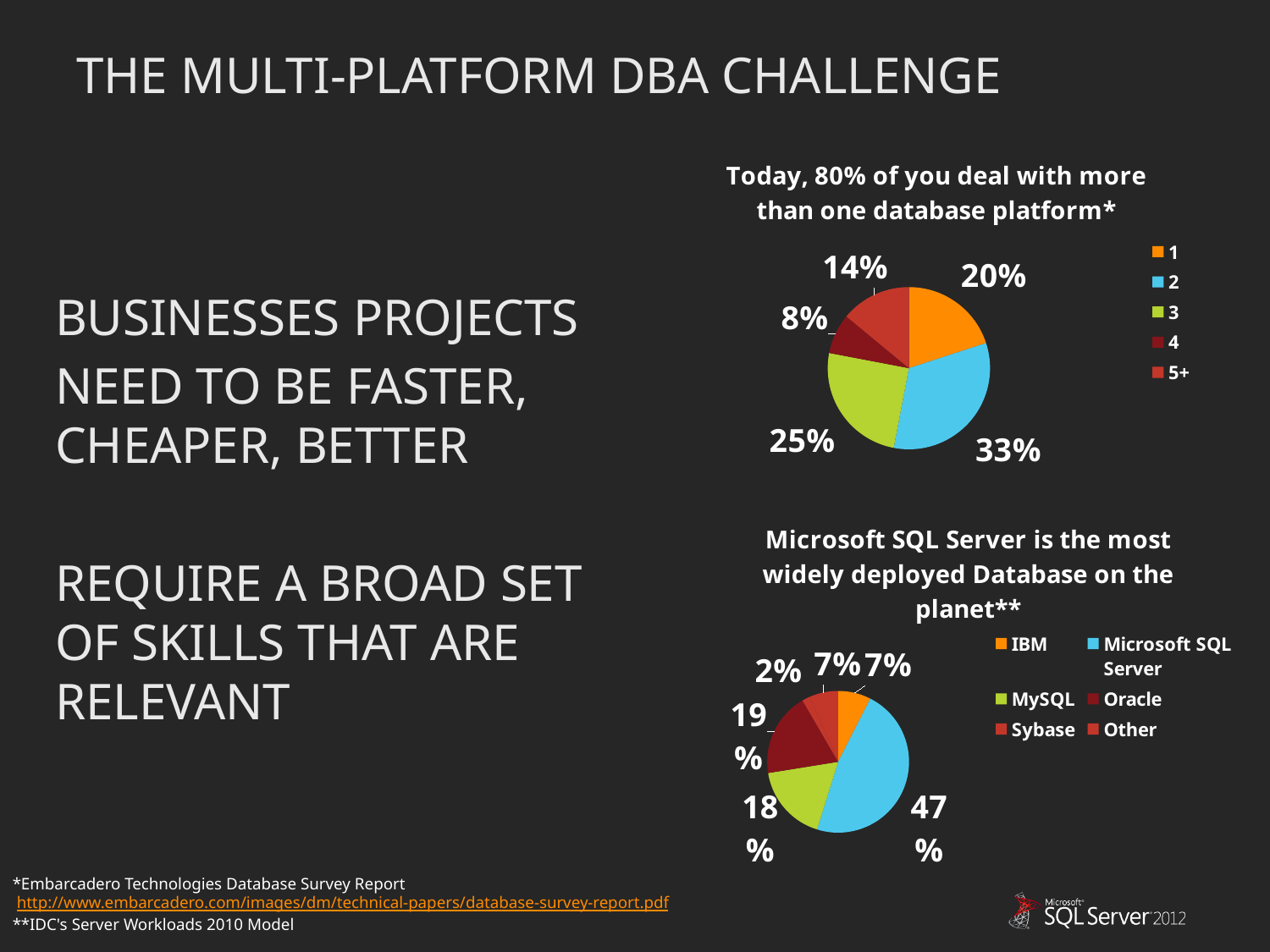
In the top pie chart, what percentage corresponds to the category '1'? 20% In the bottom pie chart, which is larger, the share for MySQL or the share for Oracle? Oracle In the top pie chart, which category has the smallest share? 4 In the bottom pie chart, what share does Microsoft SQL Server have? 47% What type of chart is used for the bottom chart on the slide? Pie chart In the top pie chart, what percentage of respondents deal with 2 database platforms? 33% In the top pie chart, which category has the largest share? 2 In the bottom pie chart, what share does Oracle have? 19% In the bottom pie chart, which database has the smallest share? Sybase In the top pie chart, what is the difference between the shares for '3' and '4'? 17% How many categories does the legend of the top pie chart list? 5 In the top pie chart, what percentage corresponds to the category '5+'? 14%